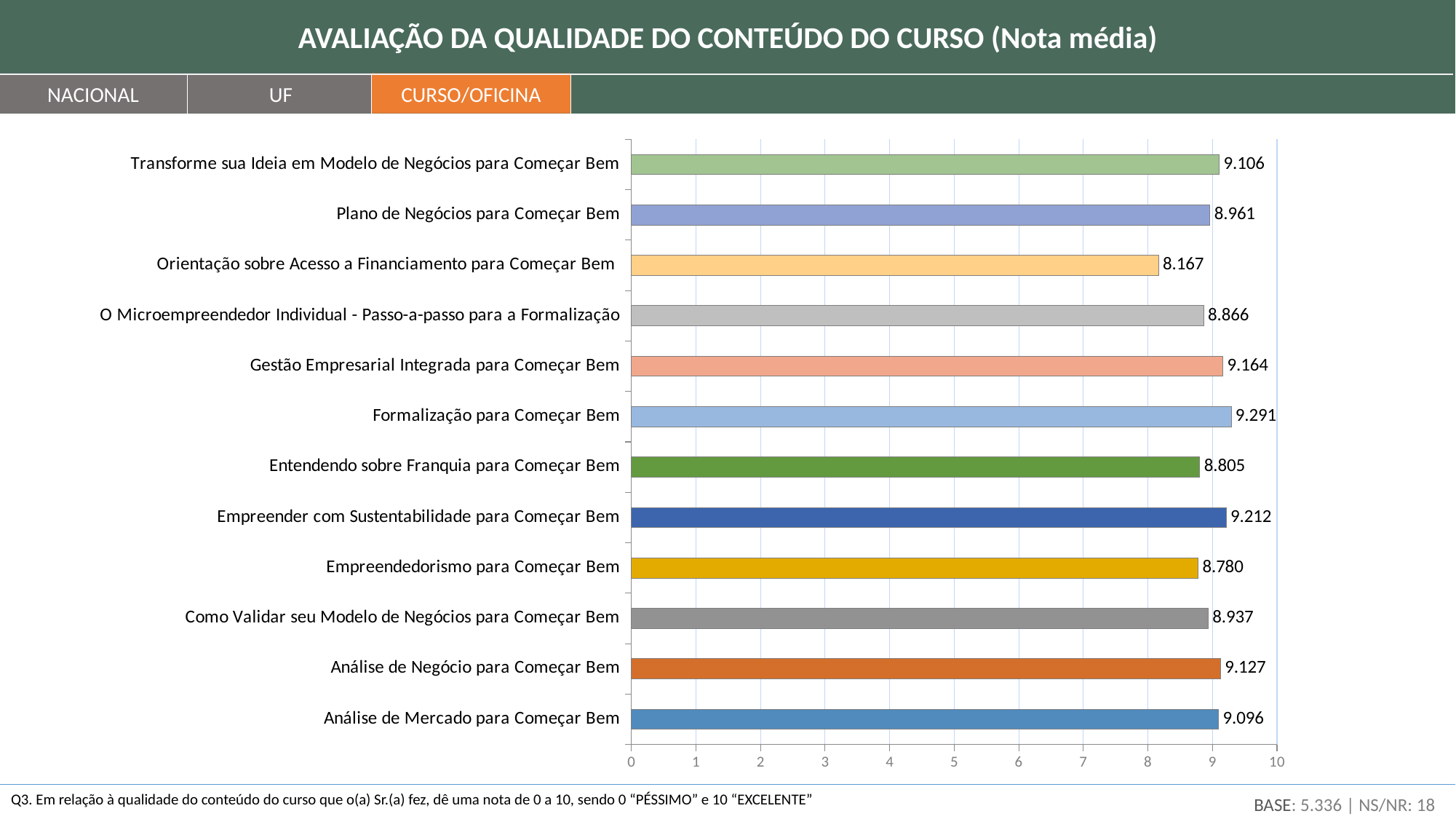
What kind of chart is shown on the slide? bar chart What is the value for Análise de Mercado para Começar Bem? 9.096 What is the value for Formalização para Começar Bem? 9.291 What is the value for Orientação sobre Acesso a Financiamento para Começar Bem? 8.167 Which is larger, the value for Gestão Empresarial Integrada para Começar Bem or the value for Plano de Negócios para Começar Bem? Gestão Empresarial Integrada para Começar Bem Is the value for Entendendo sobre Franquia para Começar Bem greater or less than 9? less What is the value for Empreendedorismo para Começar Bem? 8.780 How many courses are shown in the chart? 12 Which course has the lowest average score? Orientação sobre Acesso a Financiamento para Começar Bem What is the difference between the values for Empreender com Sustentabilidade para Começar Bem and Empreendedorismo para Começar Bem? 0.432 Which course has the highest average score? Formalização para Começar Bem What is the difference between the values for Formalização para Começar Bem and Orientação sobre Acesso a Financiamento para Começar Bem? 1.124